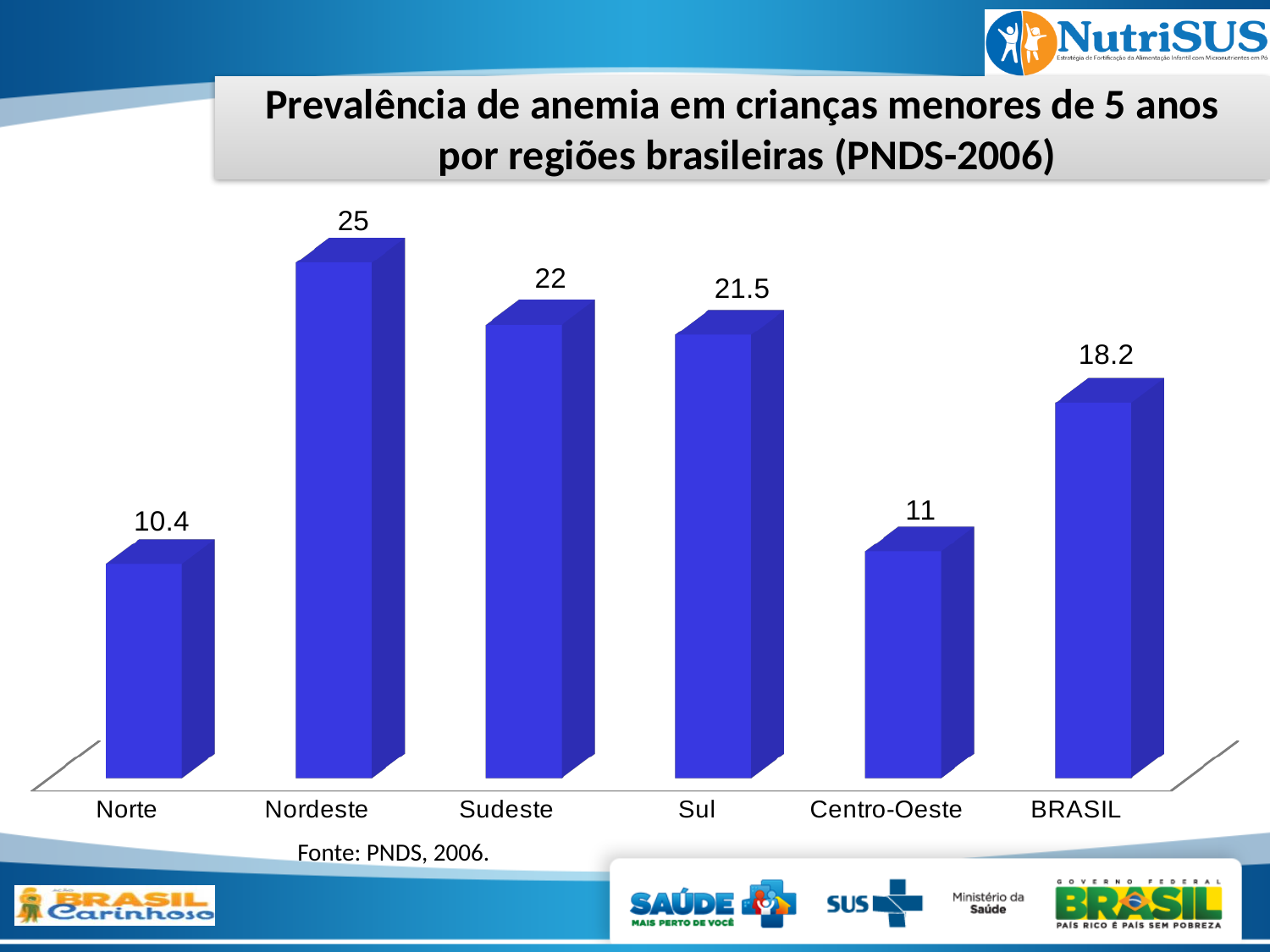
Which region has the highest value? Nordeste What kind of chart is shown? Bar chart Which is larger, the value for Sul or the value for BRASIL? Sul How many categories are shown on the x axis? 6 Which category has the lowest value? Norte What is the value for Centro-Oeste? 11 What is the value for Nordeste? 25 What source is cited below the chart? PNDS, 2006 What is the difference between the values for Nordeste and Norte? 14.6 What is the value for Norte? 10.4 What is the value for BRASIL? 18.2 What is the difference between the values for Sudeste and Sul? 0.5